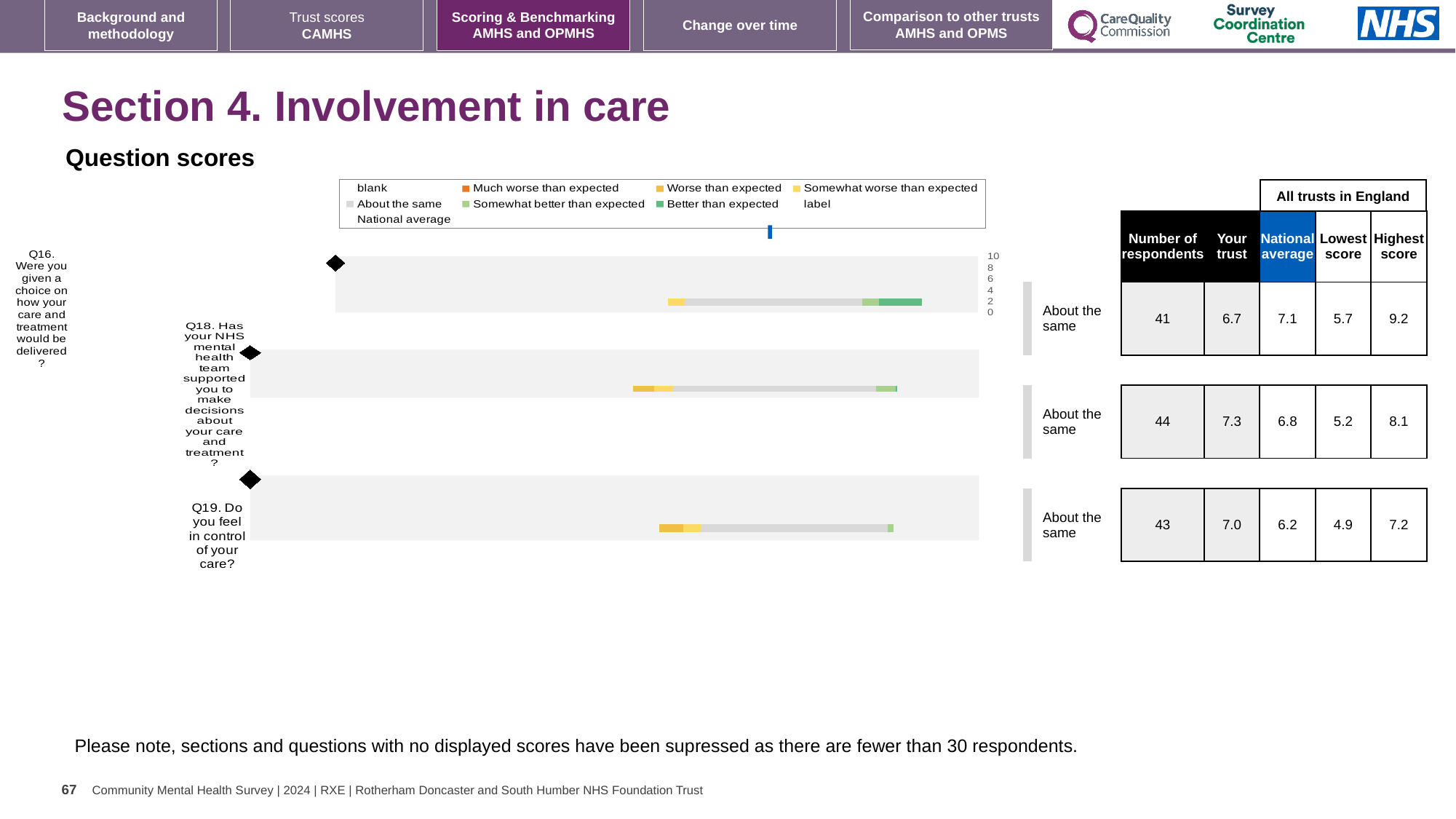
What is the difference between the 'Your trust' score and the national average for Q19? 0.8 Which question has the lowest national average score? Q19 What benchmark category label is shown next to the bar for Q18? About the same What is the highest score among all trusts in England for Q16? 9.2 What kind of chart is used to show the question scores? bar chart Which question has the highest 'Your trust' score? Q18 How many respondents are listed for Q16 (Were you given a choice on how your care and treatment would be delivered?)? 41 What is the national average score for Q19 (Do you feel in control of your care?)? 6.2 For Q16, is the 'Your trust' score higher or lower than the national average? lower What is the 'Your trust' score for Q18 (Has your NHS mental health team supported you to make decisions about your care and treatment?)? 7.3 How many questions are plotted in the chart? 3 What is the lowest score among all trusts in England for Q19? 4.9